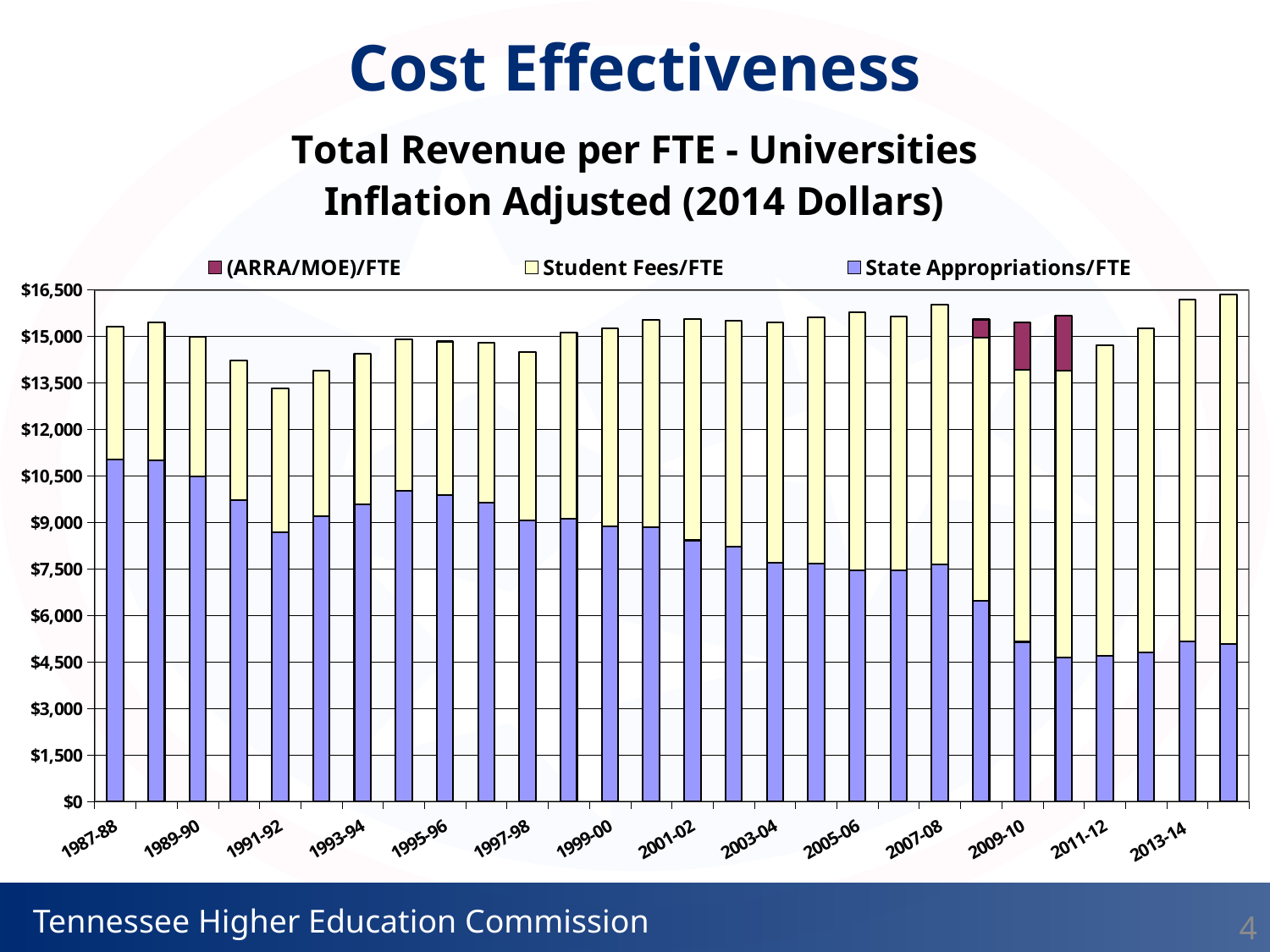
What is the title of the chart? Total Revenue per FTE - Universities Inflation Adjusted (2014 Dollars) Does the State Appropriations/FTE value generally rise or fall from 1987-88 to 2013-14? fall Is the State Appropriations/FTE value for 2013-14 greater or less than $6,000? less How many series does the legend list? 3 Is the total revenue per FTE for 2013-14 greater or less than $15,000? greater Is the State Appropriations/FTE value for 2005-06 greater or less than $9,000? less Which year has the larger State Appropriations/FTE value, 1987-88 or 2013-14? 1987-88 What kind of chart is shown on the slide? stacked bar chart Which series is shown in dark red in the legend? (ARRA/MOE)/FTE